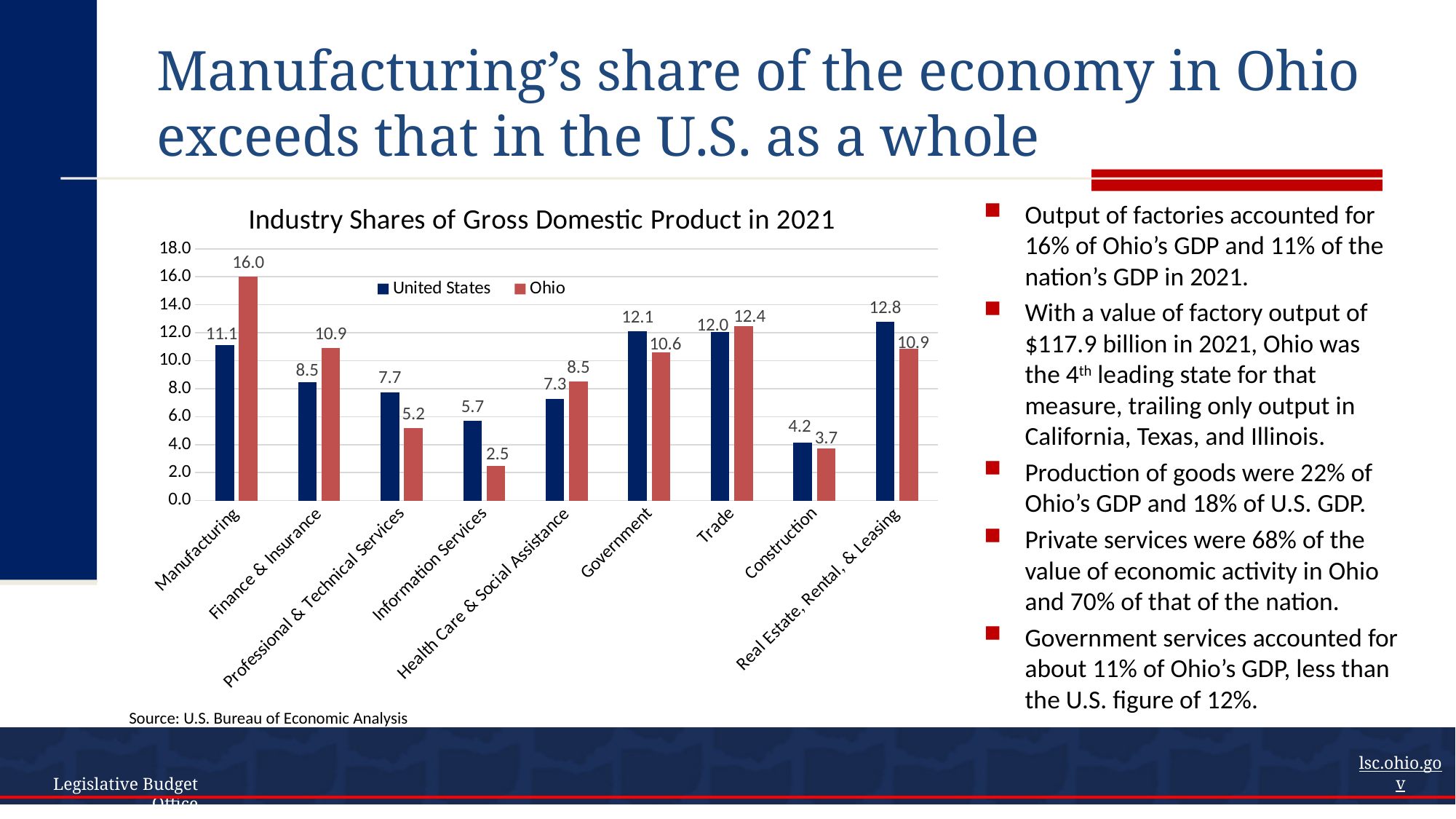
What is the Ohio value for Manufacturing? 16.0 What is the United States value for Information Services? 5.7 What is the difference between the Ohio and United States values for Manufacturing? 4.9 How many series does the legend list? 2 How many industry categories are shown on the x axis? 9 Which category has the lowest United States value? Construction What is the title of the chart? Industry Shares of Gross Domestic Product in 2021 What kind of chart is shown? Bar chart Which category has the highest Ohio value? Manufacturing Which is larger for Trade, the United States value or the Ohio value? Ohio Which is larger for Professional & Technical Services, the United States value or the Ohio value? United States What is the Ohio value for Government? 10.6